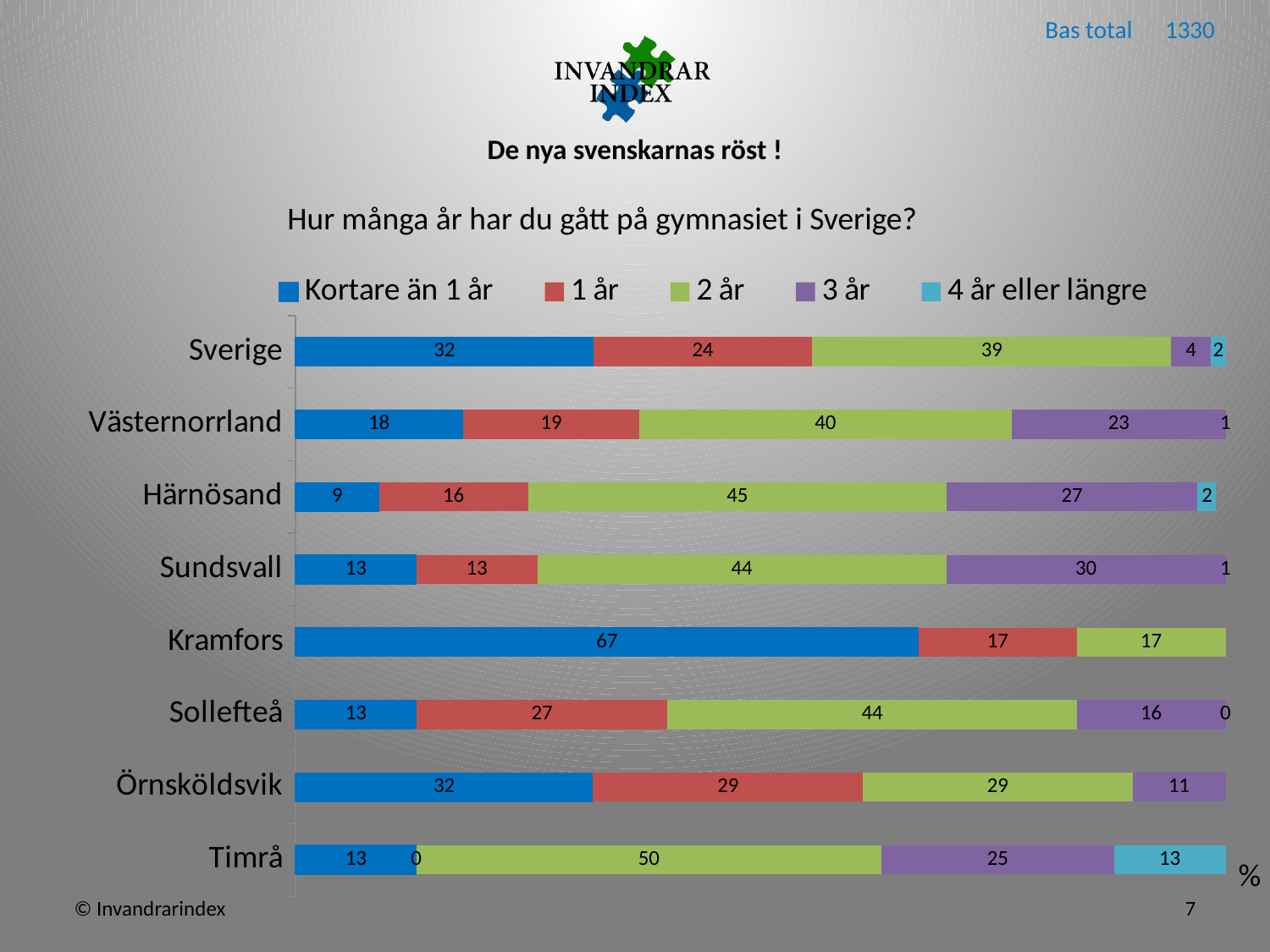
Which is larger: the "1 år" value for Sollefteå or for Härnösand? Sollefteå What is the value for "Kortare än 1 år" for Kramfors? 67 Which category has the highest value for "Kortare än 1 år"? Kramfors What is the value for "4 år eller längre" for Timrå? 13 What is the value for "3 år" for Sundsvall? 30 What kind of chart is shown on the slide? Stacked bar chart What is the total of the stacked bar for Sverige? 101 How many categories are shown on the y axis? 8 How many series does the legend list? 5 What is the difference between the "2 år" values for Timrå and Sverige? 11 What is the value for "2 år" for Sverige? 39 Which category has the lowest value for "Kortare än 1 år"? Härnösand